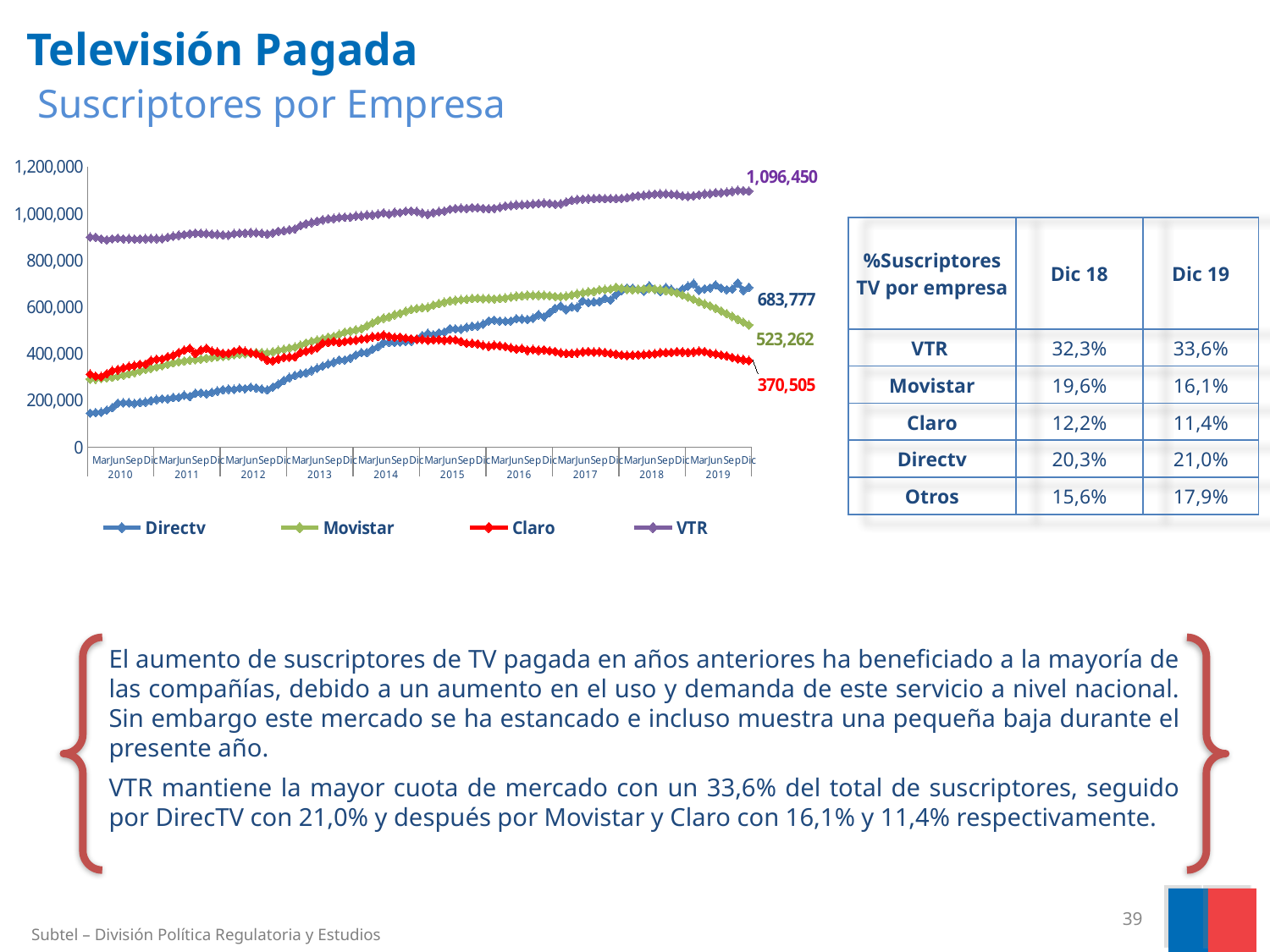
What is the final labelled value for Directv on the line chart? 683,777 How many series does the legend of the line chart list? 4 What is the difference between the final labelled values of Movistar and Claro? 152,757 What is the final labelled value for Movistar on the line chart? 523,262 Which company has the highest number of subscribers at the end of the series on the line chart? VTR Which company has the lowest number of subscribers at the end of the series on the line chart? Claro What is the difference between the final labelled values of VTR and Directv? 412,673 What is the final labelled value for Claro on the line chart? 370,505 What is the final labelled value for VTR on the line chart? 1,096,450 At the end of the series, which has more subscribers, Directv or Movistar? Directv Is the value for VTR at the start of the series (Mar 2010) greater or less than 800,000? greater What type of chart is used to show subscribers by company? Line chart